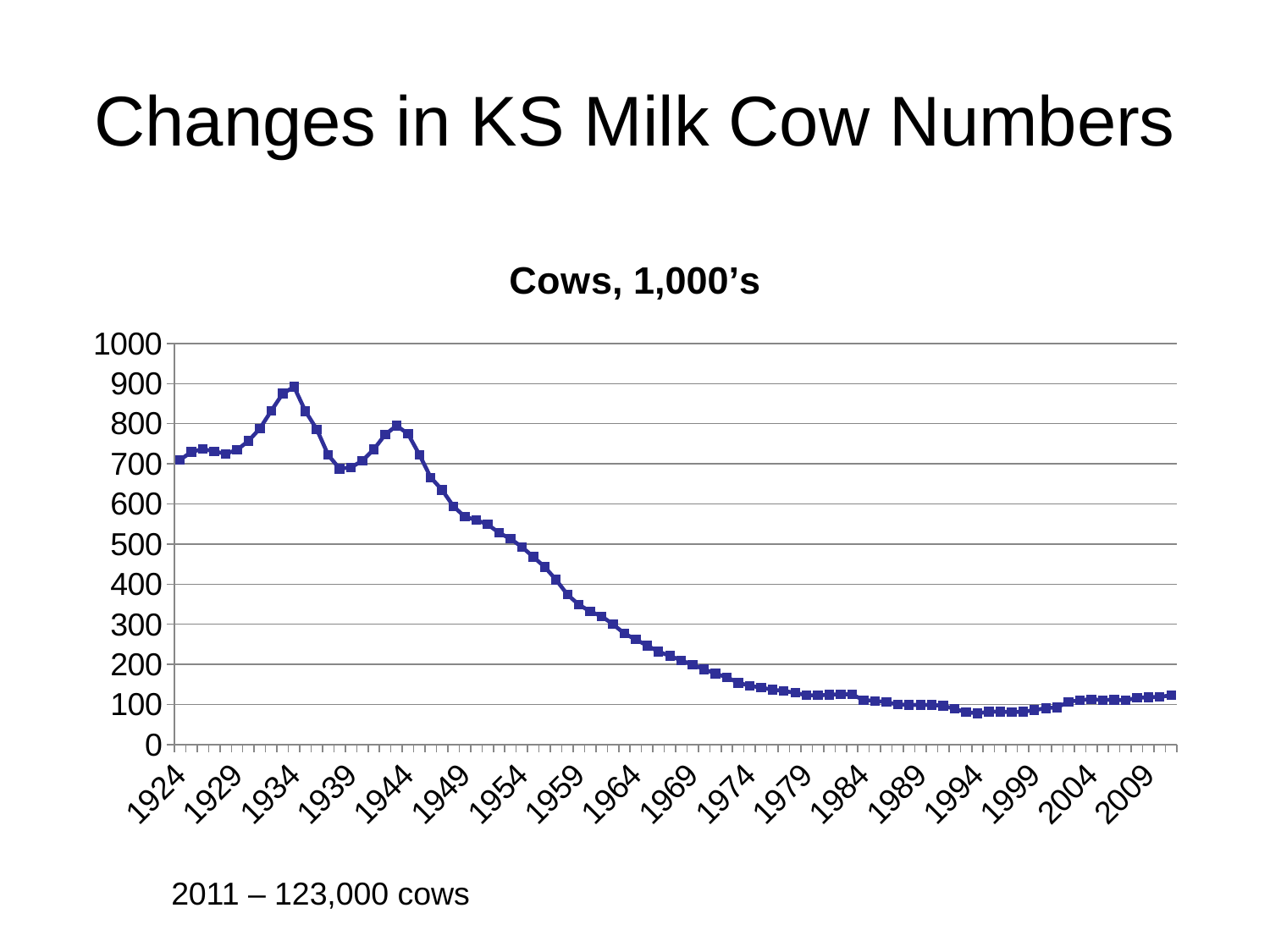
In which decade does the line reach its lowest point? 1990s Is the value for 1974 greater or less than 200? less Is the value for 1934 greater or less than 800? greater Is the value for 1994 greater or less than 100? less According to the note below the chart, how many cows were there in 2011? 123,000 cows Which peak is higher, the one around 1934 or the one around 1944? 1934 What is the title of the chart? Cows, 1,000's How many year labels are shown on the x axis? 18 Overall, do the values rise or fall from 1924 to 2009? fall What kind of chart is shown on the slide? line chart